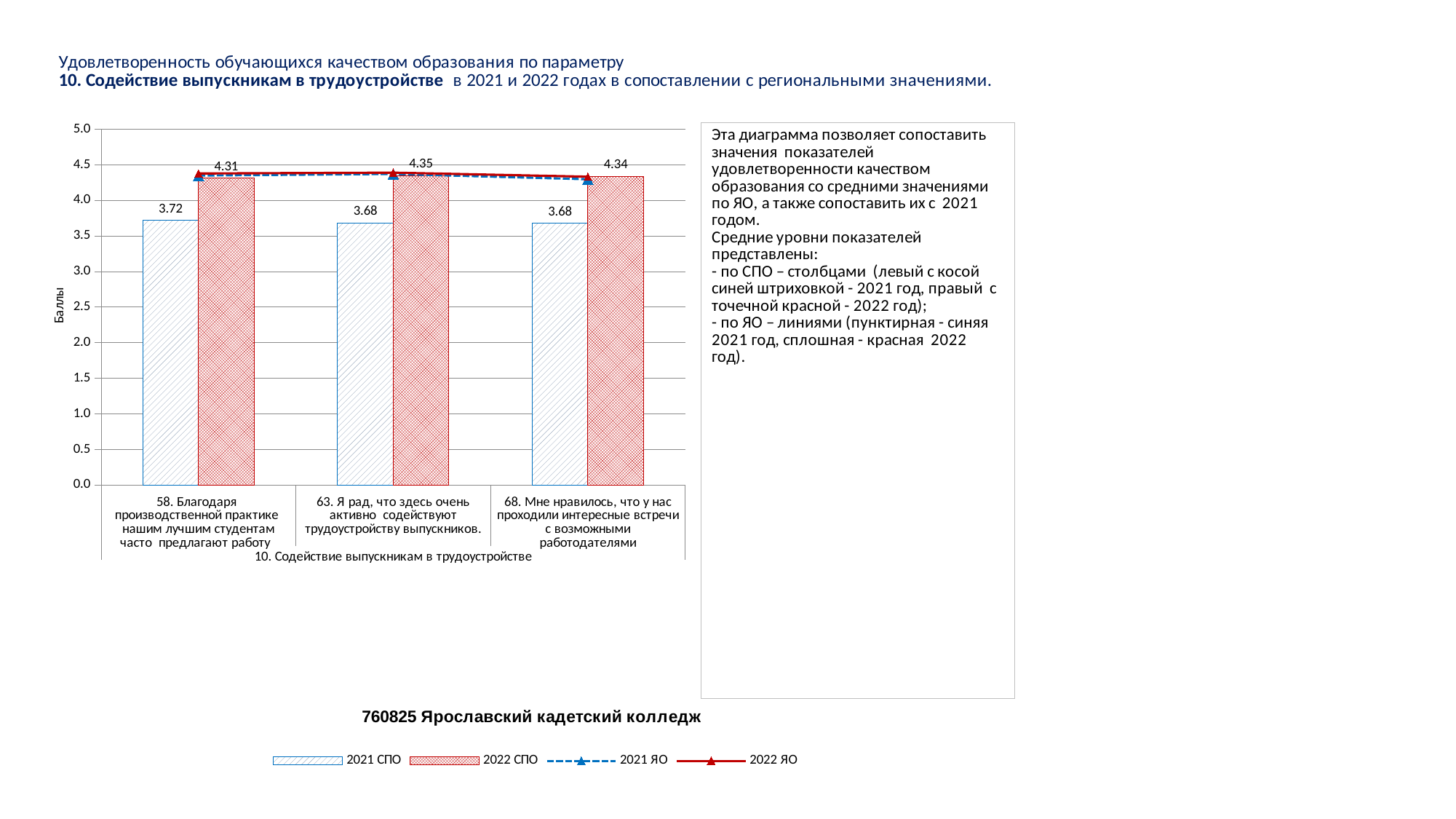
What is the 2022 СПО value for category 68 (Мне нравилось, что у нас проходили интересные встречи с возможными работодателями)? 4.34 Is the 2021 ЯО value for category 58 greater or less than 4.0? greater What is the difference between the 2022 СПО and 2021 СПО values for category 58? 0.59 Which is larger: the 2022 СПО value for category 58 or for category 68? Category 68 (4.34) Which category has the highest 2022 СПО value? 63. Я рад, что здесь очень активно содействуют трудоустройству выпускников. How many categories are shown on the x axis? 3 How many series does the legend list? 4 What is the label of the vertical axis? Баллы What is the 2022 СПО value for category 63 (Я рад, что здесь очень активно содействуют трудоустройству выпускников)? 4.35 What is the 2021 СПО value for category 58 (Благодаря производственной практике нашим лучшим студентам часто предлагают работу)? 3.72 Which category has the highest 2021 СПО value? 58. Благодаря производственной практике нашим лучшим студентам часто предлагают работу What is the difference between the 2022 СПО and 2021 СПО values for category 63? 0.67